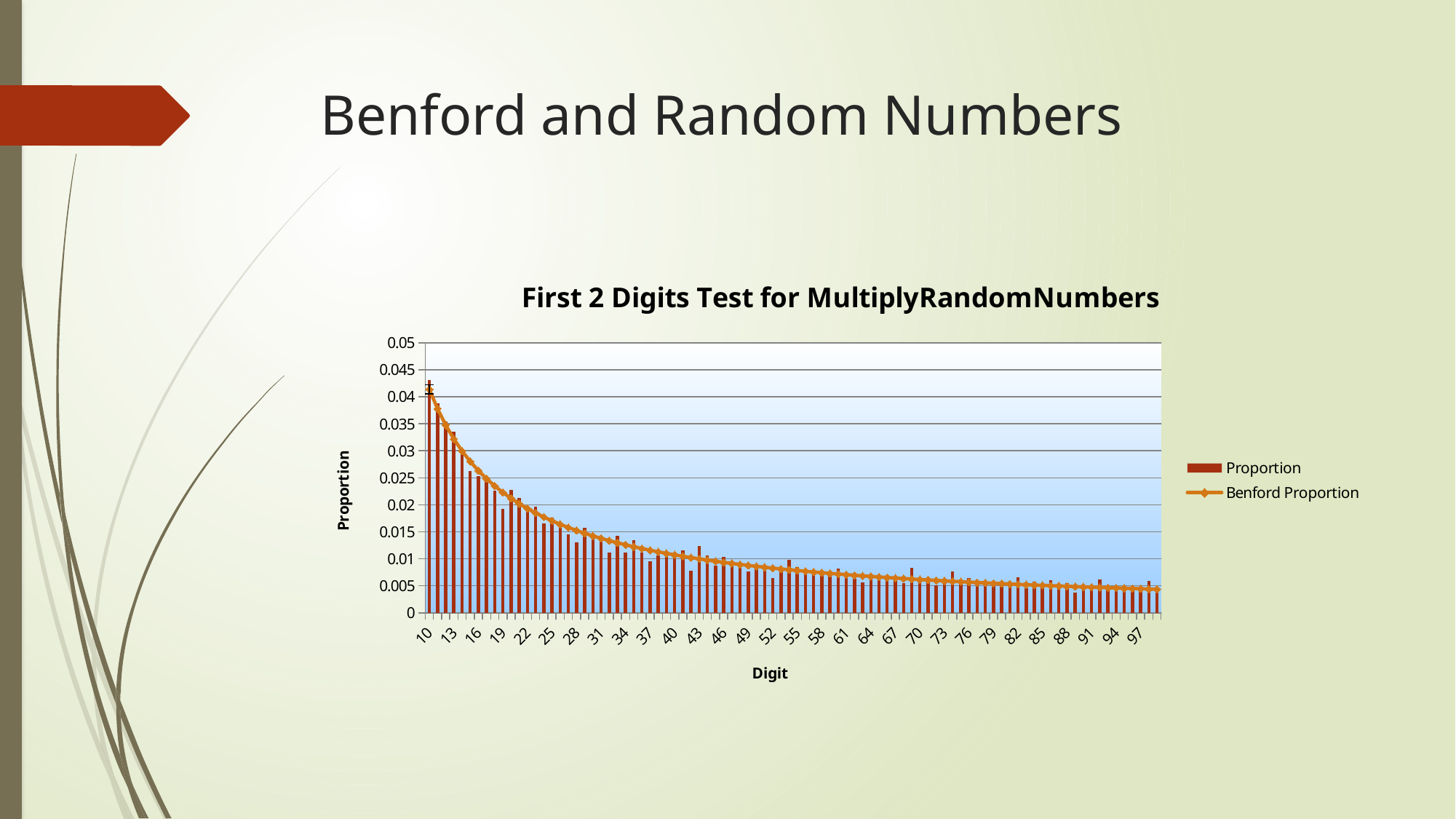
Do the Benford Proportion values rise or fall as the digit increases along the x axis? Fall What is the label of the x axis of the chart? Digit Which is larger, the Proportion for digit 13 or the Proportion for digit 52? Digit 13 What are the two series named in the chart legend? Proportion and Benford Proportion Is the Benford Proportion value for digit 22 greater or less than 0.015? greater Is the Proportion value for digit 97 greater or less than 0.01? less What kind of chart is shown on the slide? Bar chart with a line overlay Which digit has the highest Proportion bar in the chart? 10 How many series does the chart legend list? 2 What is the label of the y axis of the chart? Proportion Is the Proportion value for digit 10 greater or less than 0.04? greater What is the title of the chart on the slide? First 2 Digits Test for MultiplyRandomNumbers